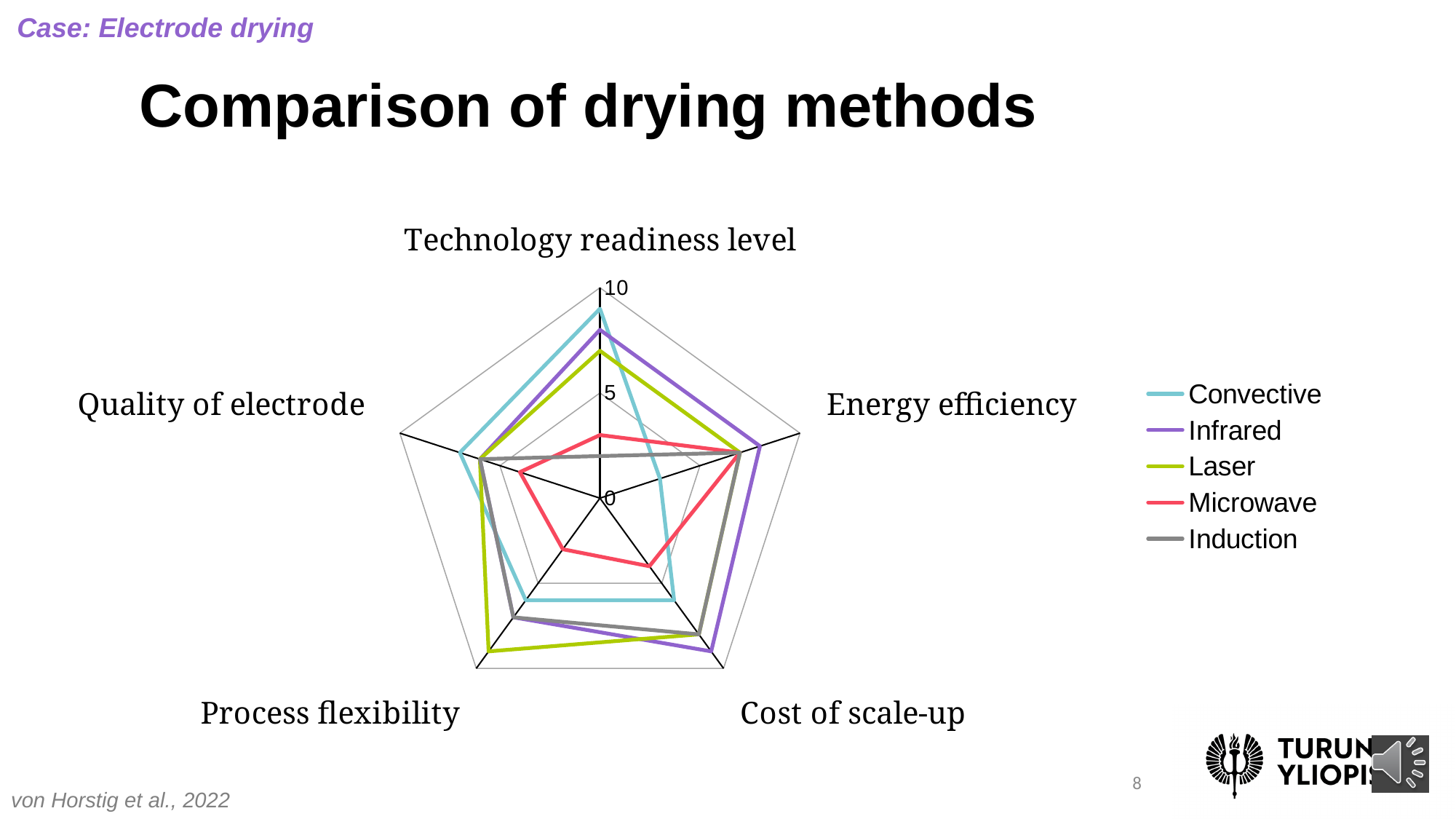
Which drying method scores lowest on Cost of scale-up? Microwave Is the Process flexibility value for Laser greater or less than 5? greater Which drying method scores highest on Technology readiness level? Convective Is the Technology readiness level value for Microwave greater or less than 5? less What is the title of the chart? Comparison of drying methods Which drying method scores lowest on Technology readiness level? Induction Which drying method scores highest on Process flexibility? Laser How many series does the legend list? 5 What kind of chart is shown on the slide? Radar chart Is the Energy efficiency value for Convective greater or less than 5? less How many criteria (axes) does the radar chart compare the drying methods on? 5 Which has the higher Energy efficiency value, Infrared or Microwave? Infrared